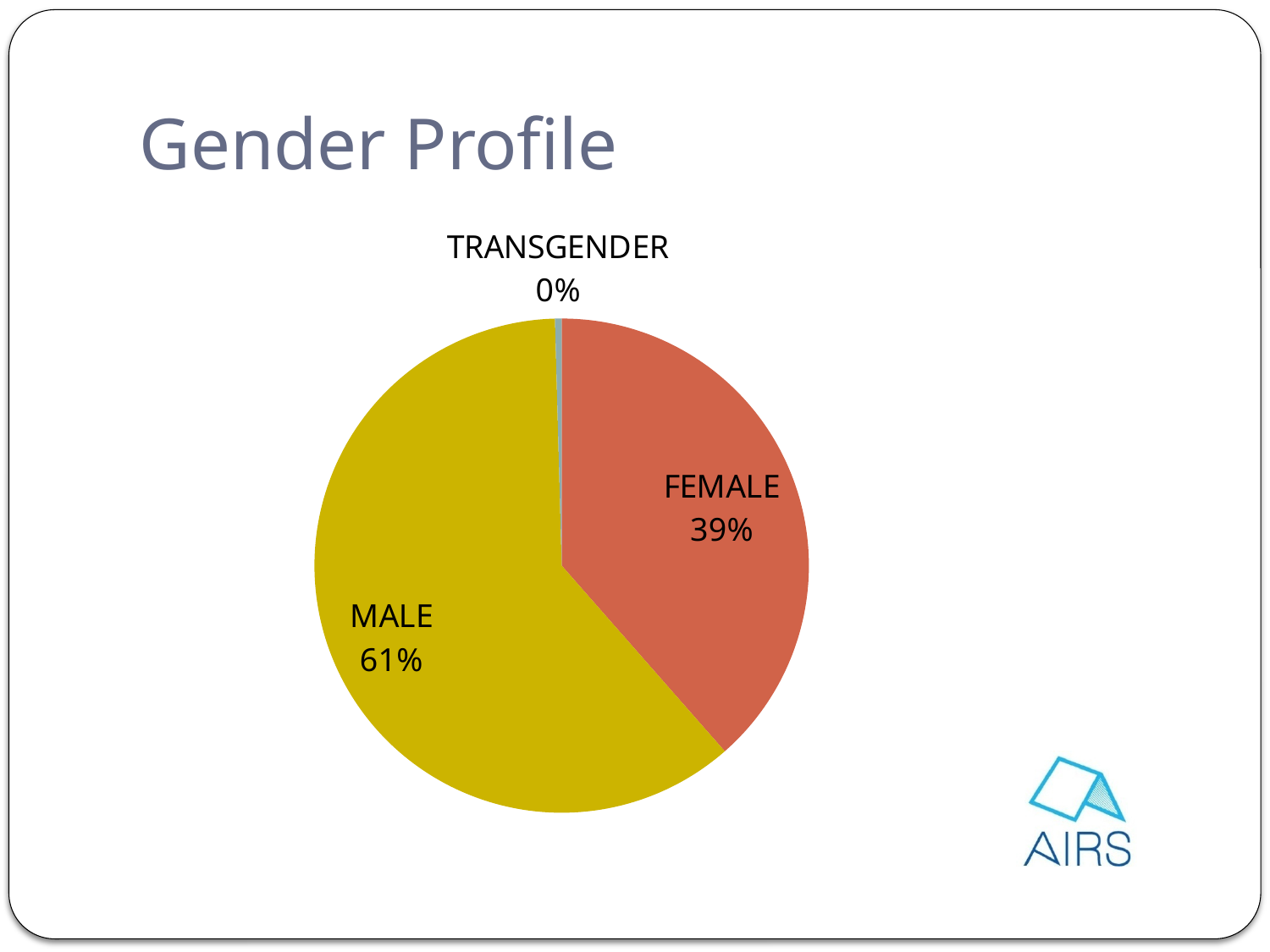
What percentage of the pie is MALE? 61% What is the title of the slide? Gender Profile What is the combined share of MALE and FEMALE? 100% What type of chart is shown on the slide? pie chart What percentage of the pie is TRANSGENDER? 0% Which category has the largest share of the pie? MALE What percentage of the pie is FEMALE? 39% Which is larger, the MALE share or the FEMALE share? MALE What colour is the MALE slice of the pie? yellow Which category has the smallest share of the pie? TRANSGENDER What is the difference in percentage points between the MALE and FEMALE shares? 22 How many categories are shown in the pie chart? 3